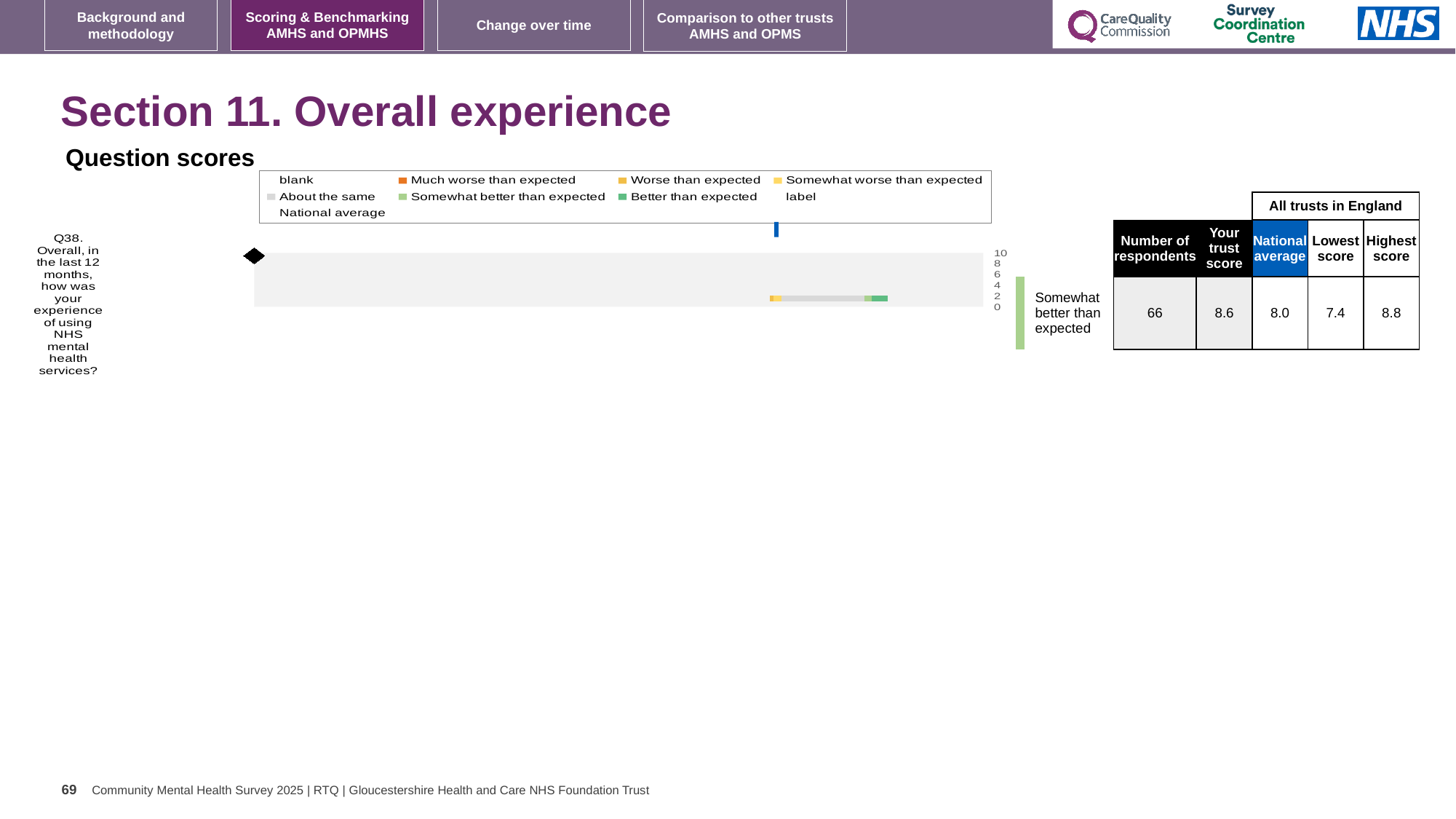
Is the trust's score for Q38 greater or less than 8? greater Which rating category is shown next to the chart for Q38? Somewhat better than expected What is the lowest score among all trusts in England for Q38? 7.4 What is the national average score for Q38? 8.0 What is the difference between the highest and lowest scores for Q38 across all trusts in England? 1.4 Which is larger for Q38: the trust's score or the national average? the trust's score How many respondents answered Q38? 66 What is the highest score among all trusts in England for Q38? 8.8 By how much does the trust's score for Q38 exceed the national average? 0.6 What is the trust's score for Q38 (Overall, in the last 12 months, how was your experience of using NHS mental health services?)? 8.6 What kind of chart is used to show the Q38 question score? bar chart How many survey questions are plotted on the chart? 1